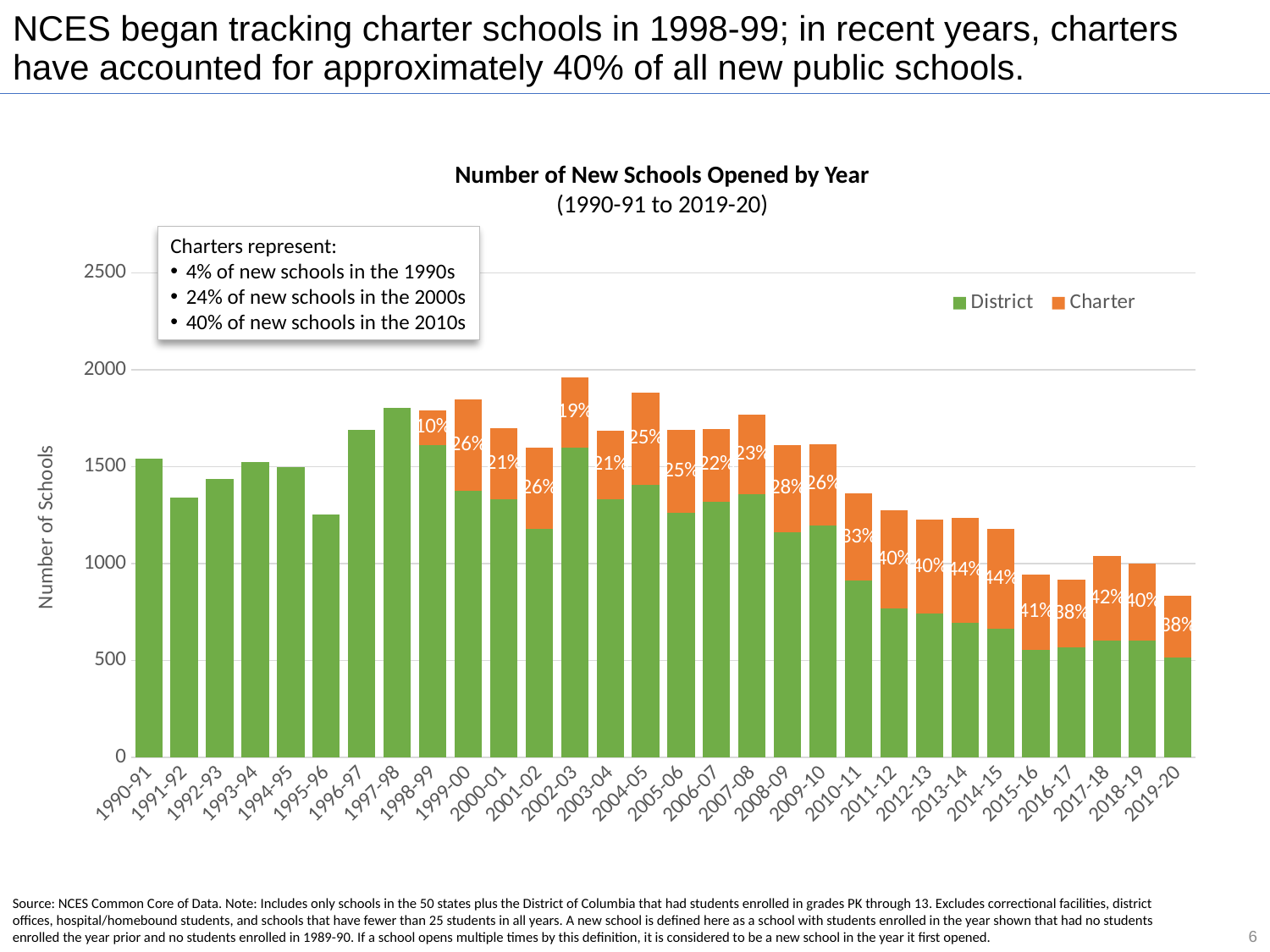
How many series does the legend list? 2 Is the total number of new schools opened in 1995-96 greater or less than 1500? less What type of chart is shown on the slide? Stacked bar chart Which school year has the highest total number of new schools opened? 2002-03 What percentage label is shown on the Charter segment for 2013-14? 44% What is the difference in percentage points between the charter share labels for 2013-14 and 1998-99? 34 percentage points What percentage label is shown on the Charter segment for 2019-20? 38% Which is larger, the charter percentage label for 2010-11 or for 2016-17? 2016-17 Which school year has the lowest total number of new schools opened? 2019-20 How many school years are shown along the x axis? 30 Is the total number of new schools opened in 2019-20 greater or less than 1000? less What percentage of new schools were charters in 1998-99, according to the data label? 10%